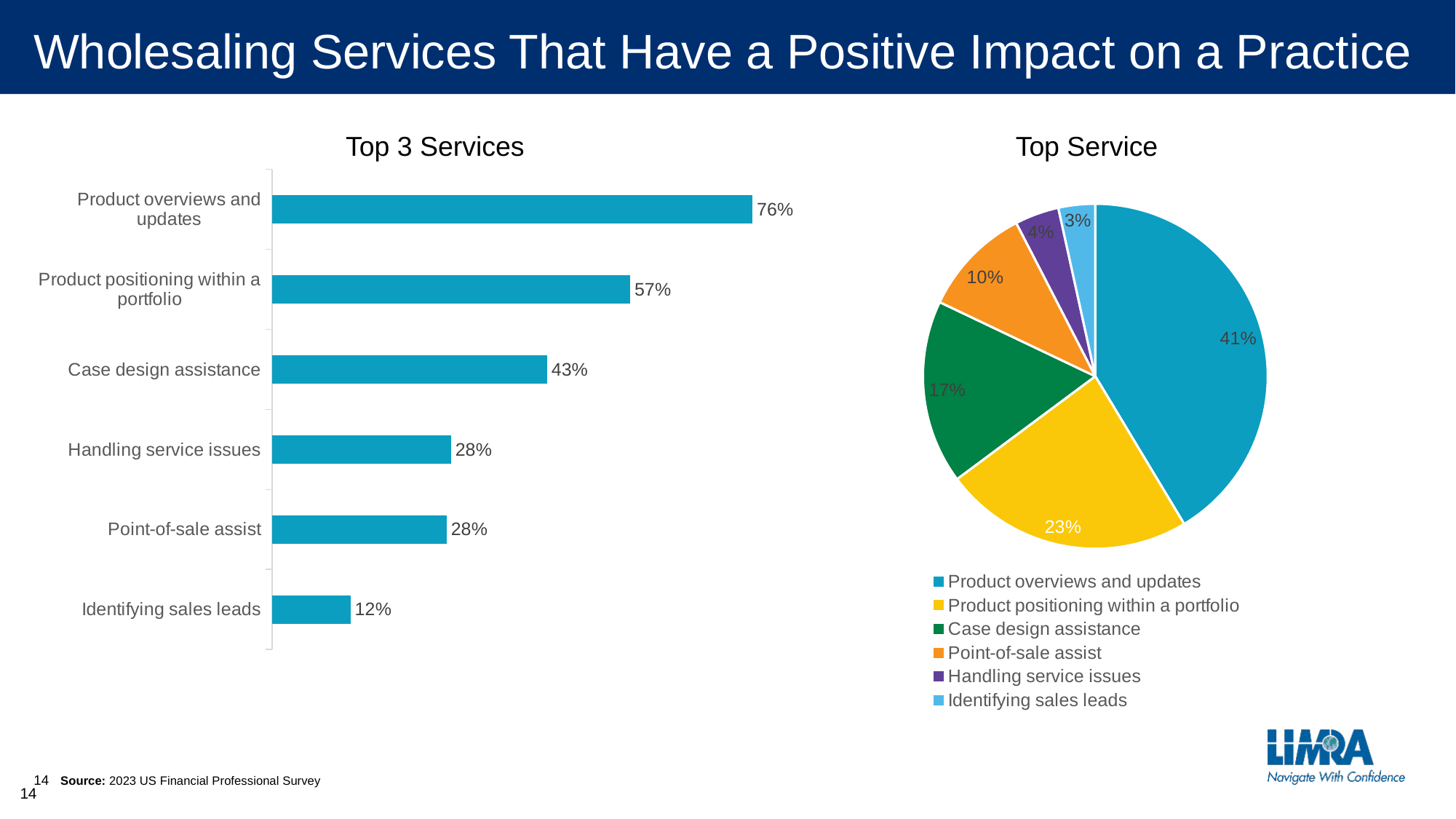
In the 'Top Service' chart, what is the value for Point-of-sale assist? 10% What kind of chart is the 'Top Service' chart? Pie chart In the 'Top Service' chart, what share does Product positioning within a portfolio have? 23% In the 'Top 3 Services' chart, what is the value for Case design assistance? 43% In the 'Top Service' chart, which category has the largest slice? Product overviews and updates In the 'Top 3 Services' chart, which category has the lowest value? Identifying sales leads In the 'Top 3 Services' chart, what is the difference between Product overviews and updates and Product positioning within a portfolio? 19% In the 'Top 3 Services' chart, which is larger: Case design assistance or Handling service issues? Case design assistance How many entries does the legend of the 'Top Service' chart list? 6 How many categories are shown in the 'Top 3 Services' chart? 6 In the 'Top 3 Services' chart, what is the value for Product overviews and updates? 76% What kind of chart is the 'Top 3 Services' chart? Bar chart